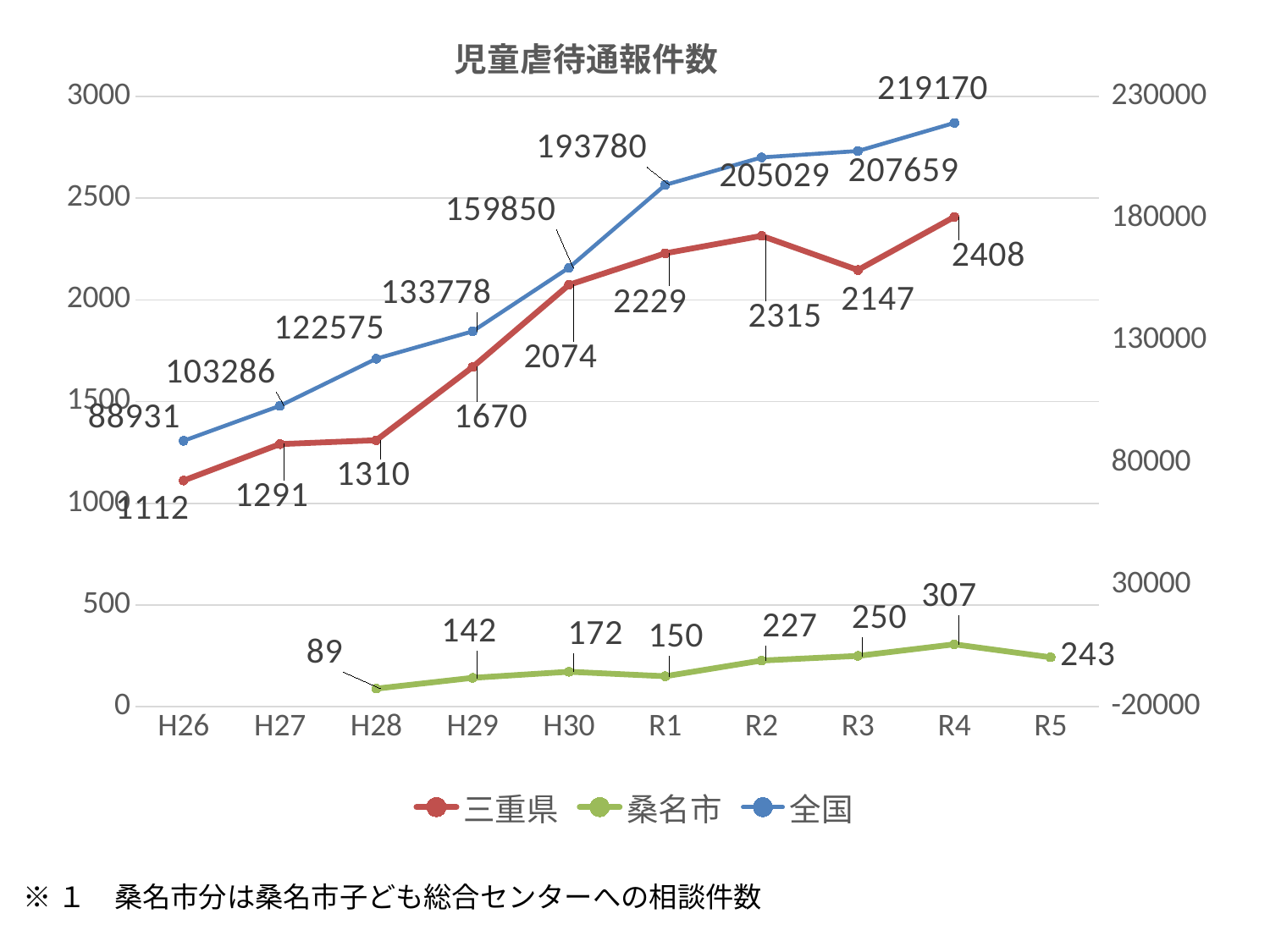
How many series does the legend list? 3 What is the difference between the 三重県 values in R4 and R3? 261 In which year is the value for 三重県 the lowest? H26 What is the difference between the 全国 values in R4 and H26? 130239 What is the value for 桑名市 in R5? 243 Which is larger for 三重県: the value in R2 or the value in R3? R2 What is the value for 全国 in R1? 193780 What is the value for 三重県 in H30? 2074 What kind of chart is this? Line chart Does the 全国 series rise or fall from H26 to R4? Rise In which year does 桑名市 reach its highest value? R4 How many categories are shown on the x axis? 10